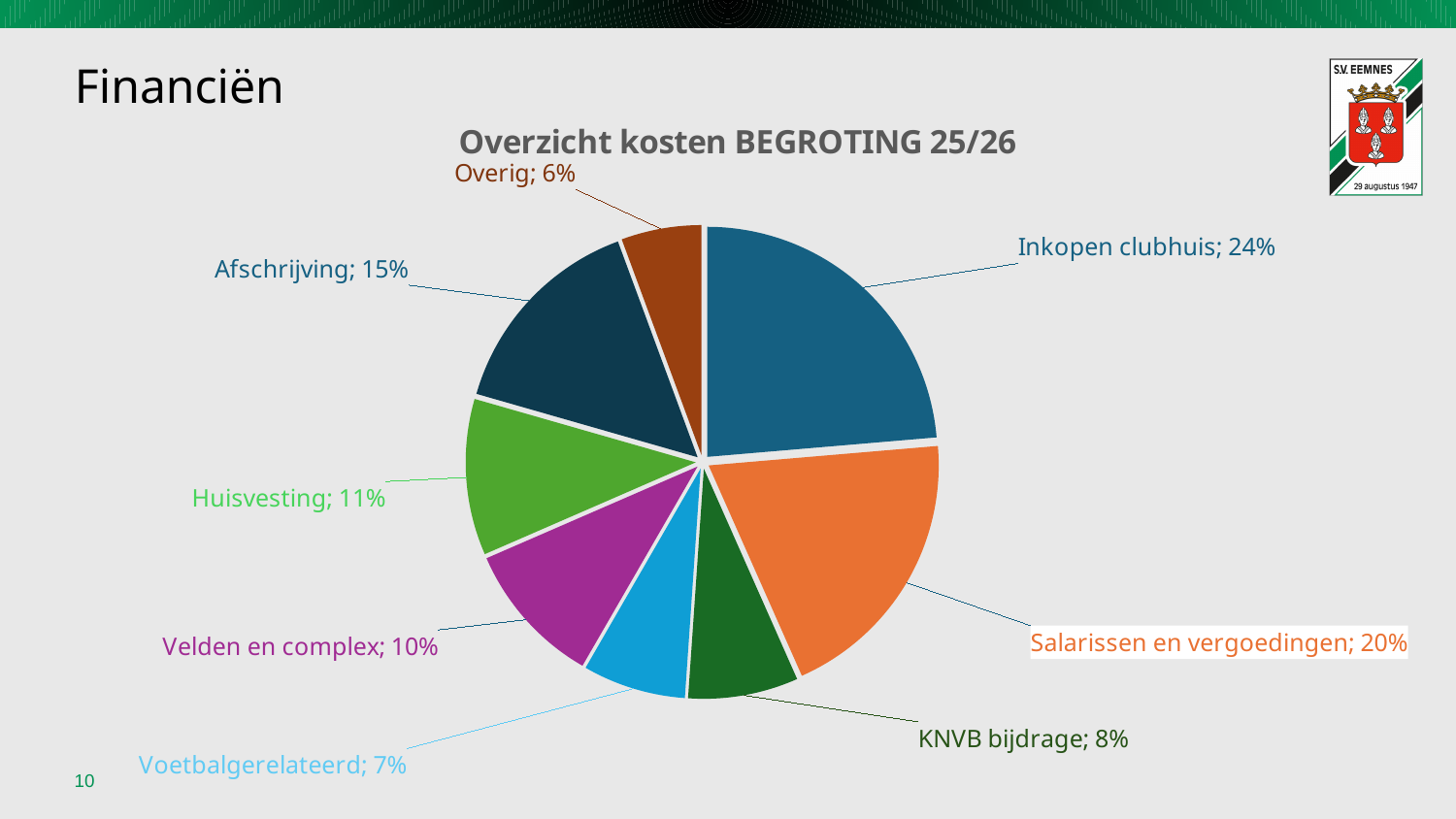
What is the combined share of Voetbalgerelateerd and Overig? 13% What is the value shown for Salarissen en vergoedingen? 20% What is the title of the chart? Overzicht kosten BEGROTING 25/26 Which category has the smallest slice of the pie? Overig How many categories are shown in the pie chart? 8 Which category has the largest slice of the pie? Inkopen clubhuis What is the difference between the shares of Inkopen clubhuis and Salarissen en vergoedingen? 4% What is the value shown for Afschrijving? 15% What share of the pie does Inkopen clubhuis represent? 24% What kind of chart is shown on the slide? Pie chart Which is larger, the share for Velden en complex or the share for KNVB bijdrage? Velden en complex What is the value shown for Huisvesting? 11%